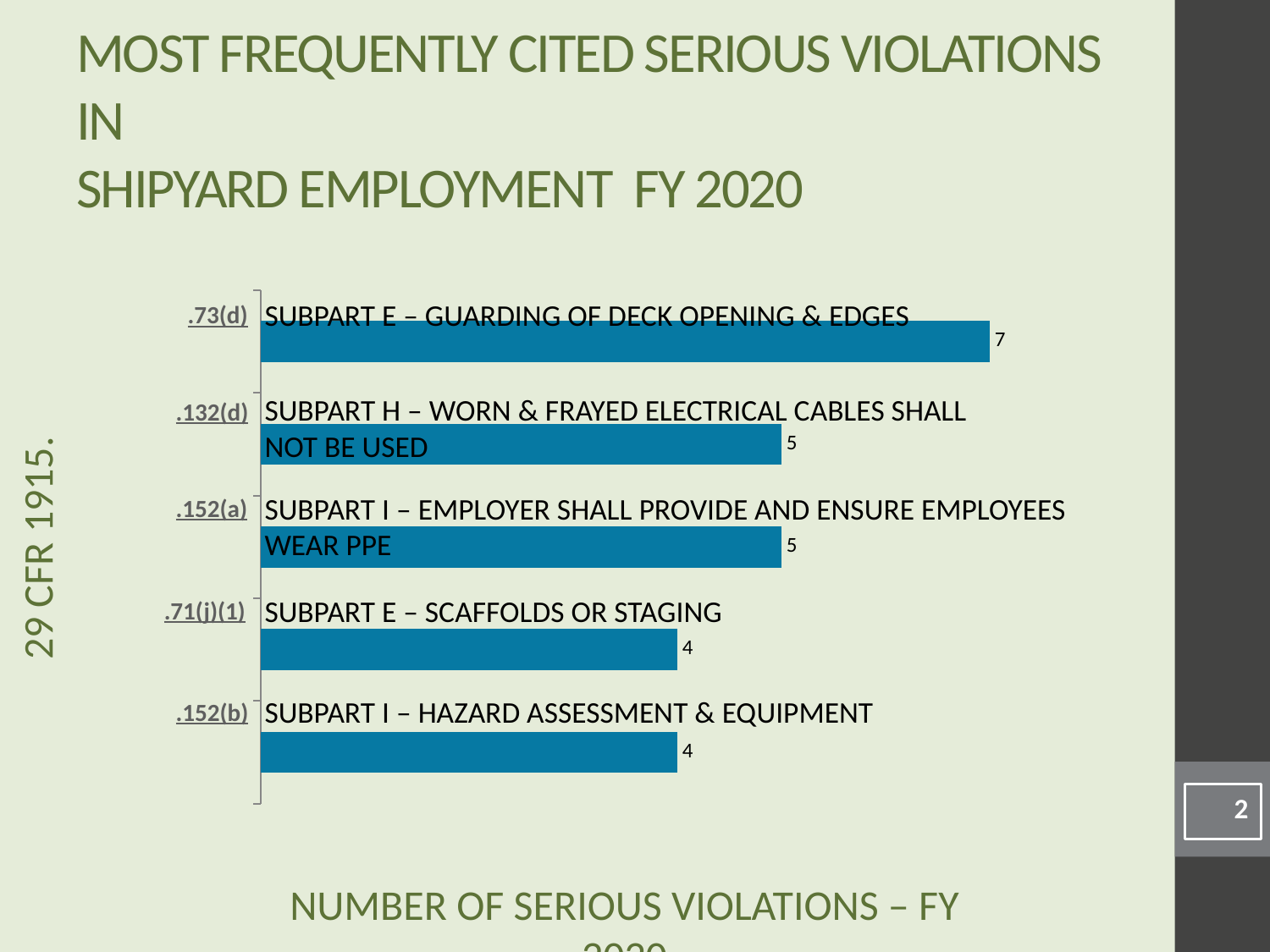
What is the number of serious violations for .71(j)(1) (Subpart E – Scaffolds or Staging)? 4 What is the number of serious violations for .132(d) (Subpart H – Worn & Frayed Electrical Cables Shall Not Be Used)? 5 What is the difference between the number of violations for .132(d) and .71(j)(1)? 1 What is the number of serious violations for .73(d) (Subpart E – Guarding of Deck Opening & Edges)? 7 What type of chart is shown on the slide? Bar chart Which standard has the highest number of serious violations? .73(d) How many standards (categories) are shown in the chart? 5 Which has more serious violations, .73(d) or .152(b)? .73(d) What is the difference between the number of violations for .73(d) and .152(a)? 2 What is the total number of serious violations across all five standards shown? 25 What is the number of serious violations for .152(b) (Subpart I – Hazard Assessment & Equipment)? 4 Which has more serious violations, .152(a) or .71(j)(1)? .152(a)